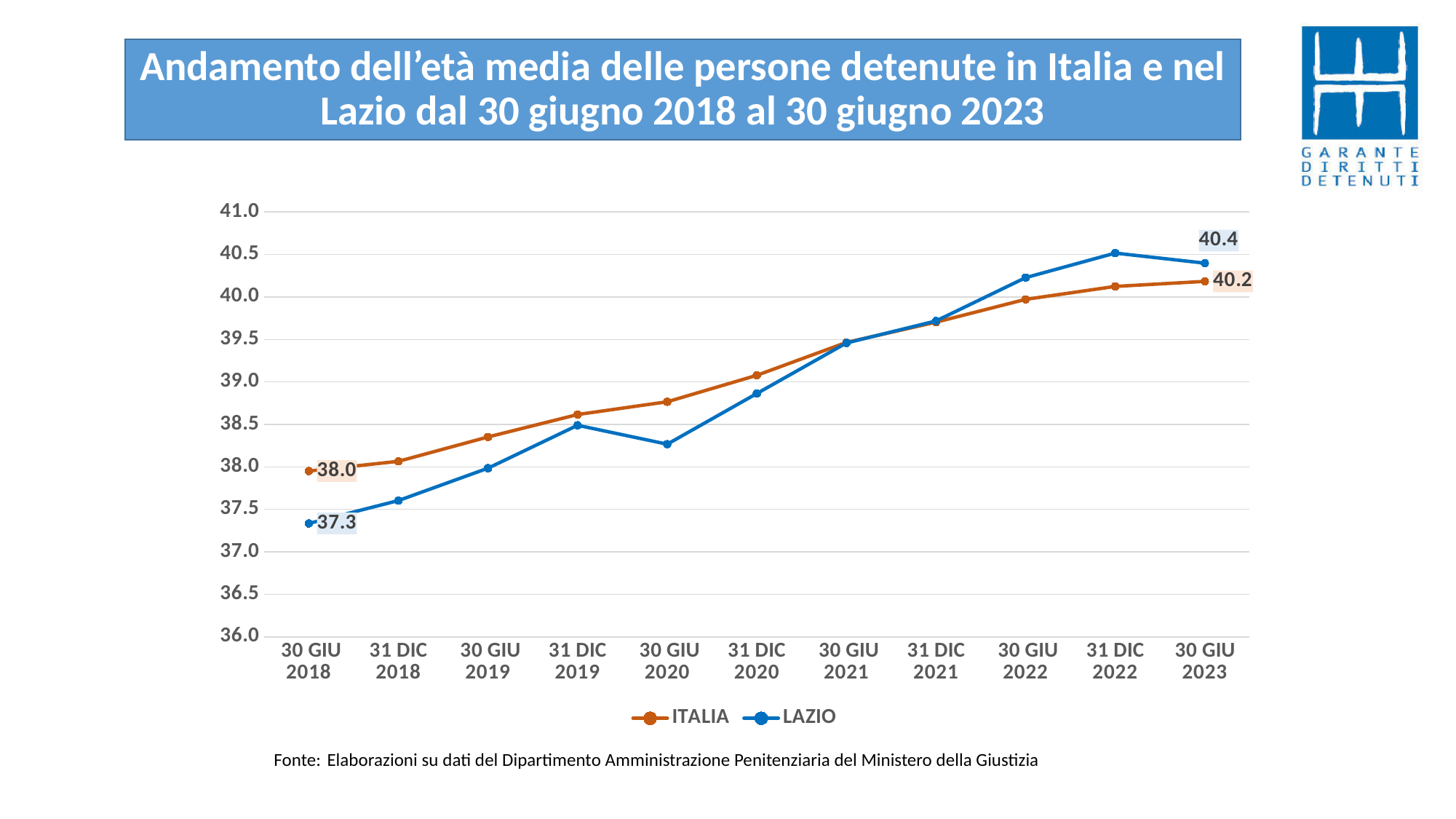
What is the average age for LAZIO at 30 GIU 2018? 37.3 What is the average age for ITALIA at 30 GIU 2023? 40.2 How many series does the legend list? 2 By how much did the LAZIO value increase from 30 GIU 2018 to 30 GIU 2023? 3.1 At 30 GIU 2018, which series has the higher value, ITALIA or LAZIO? ITALIA What is the average age for ITALIA at 30 GIU 2018? 38.0 What is the average age for LAZIO at 30 GIU 2023? 40.4 At 30 GIU 2023, which series has the higher value, ITALIA or LAZIO? LAZIO Is the value for LAZIO at 30 GIU 2020 greater or less than 38.5? less How many time points are plotted on the x axis? 11 What kind of chart is shown on the slide? line chart By how much did the ITALIA value increase from 30 GIU 2018 to 30 GIU 2023? 2.2